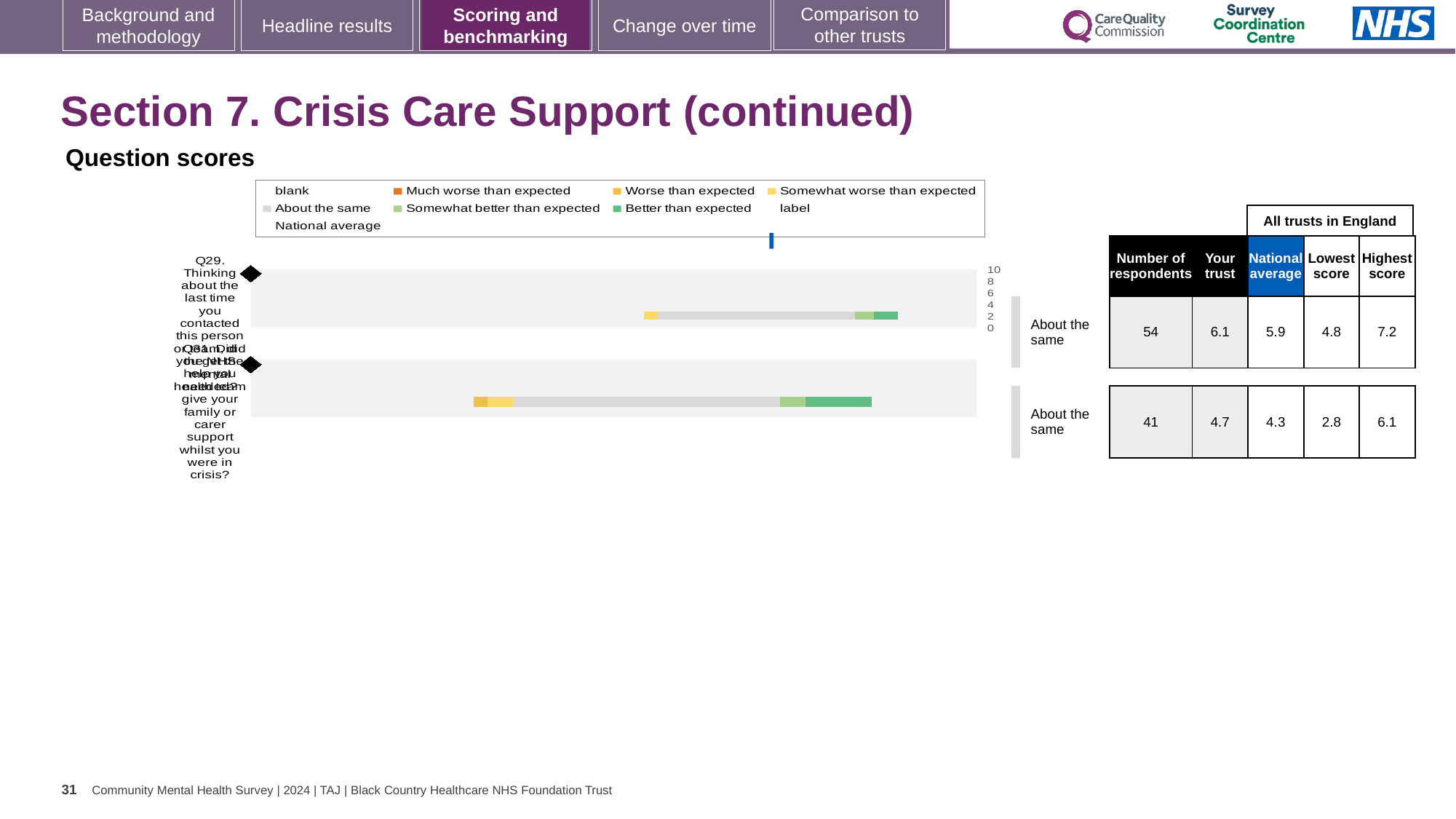
What is the number of respondents for Q29 (the top row of the table)? 54 What is the difference between the 'Your trust' score and the national average for Q31 (the bottom row of the table)? 0.4 What is the lowest score among all trusts in England for Q31 (the bottom row of the table)? 2.8 Which question has the larger 'Your trust' score, Q29 or Q31? Q29 What is the 'Your trust' score for Q31 (the bottom row of the table)? 4.7 What is the highest score among all trusts in England for Q29 (the top row of the table)? 7.2 What benchmark category is shown next to the bar for Q29? About the same What kind of chart is used to show the question scores on this slide? bar chart What is the title of the chart section on this slide? Question scores How many questions are plotted as bars in the question scores chart? 2 What is the national average for Q29 (the top row of the table)? 5.9 What is the 'Your trust' score for Q29 (the top row of the table)? 6.1